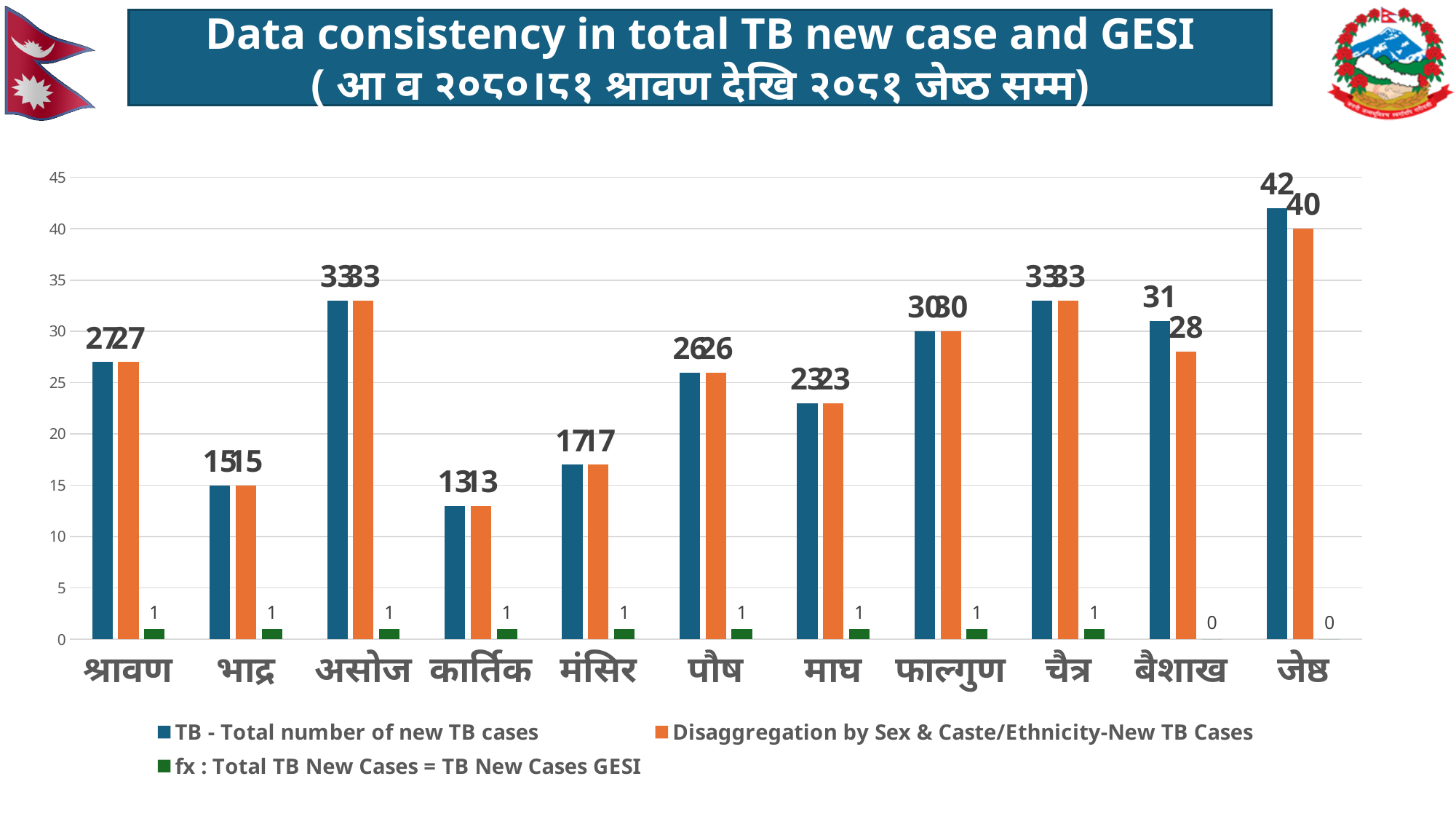
What is the value of 'TB - Total number of new TB cases' for कार्तिक? 13 What is the value of the 'fx : Total TB New Cases = TB New Cases GESI' series for बैशाख? 0 What is the value of 'TB - Total number of new TB cases' for जेष्ठ? 42 What type of chart is shown on the slide? bar chart Which is larger for जेष्ठ: 'TB - Total number of new TB cases' or 'Disaggregation by Sex & Caste/Ethnicity-New TB Cases'? TB - Total number of new TB cases What is the value of 'Disaggregation by Sex & Caste/Ethnicity-New TB Cases' for बैशाख? 28 What colour are the bars for 'Disaggregation by Sex & Caste/Ethnicity-New TB Cases'? orange Which month has the lowest value for 'TB - Total number of new TB cases'? कार्तिक How many series does the legend list? 3 How many months (categories) are shown on the x axis? 11 What is the difference between 'TB - Total number of new TB cases' and 'Disaggregation by Sex & Caste/Ethnicity-New TB Cases' for बैशाख? 3 Which month has the highest value for 'TB - Total number of new TB cases'? जेष्ठ